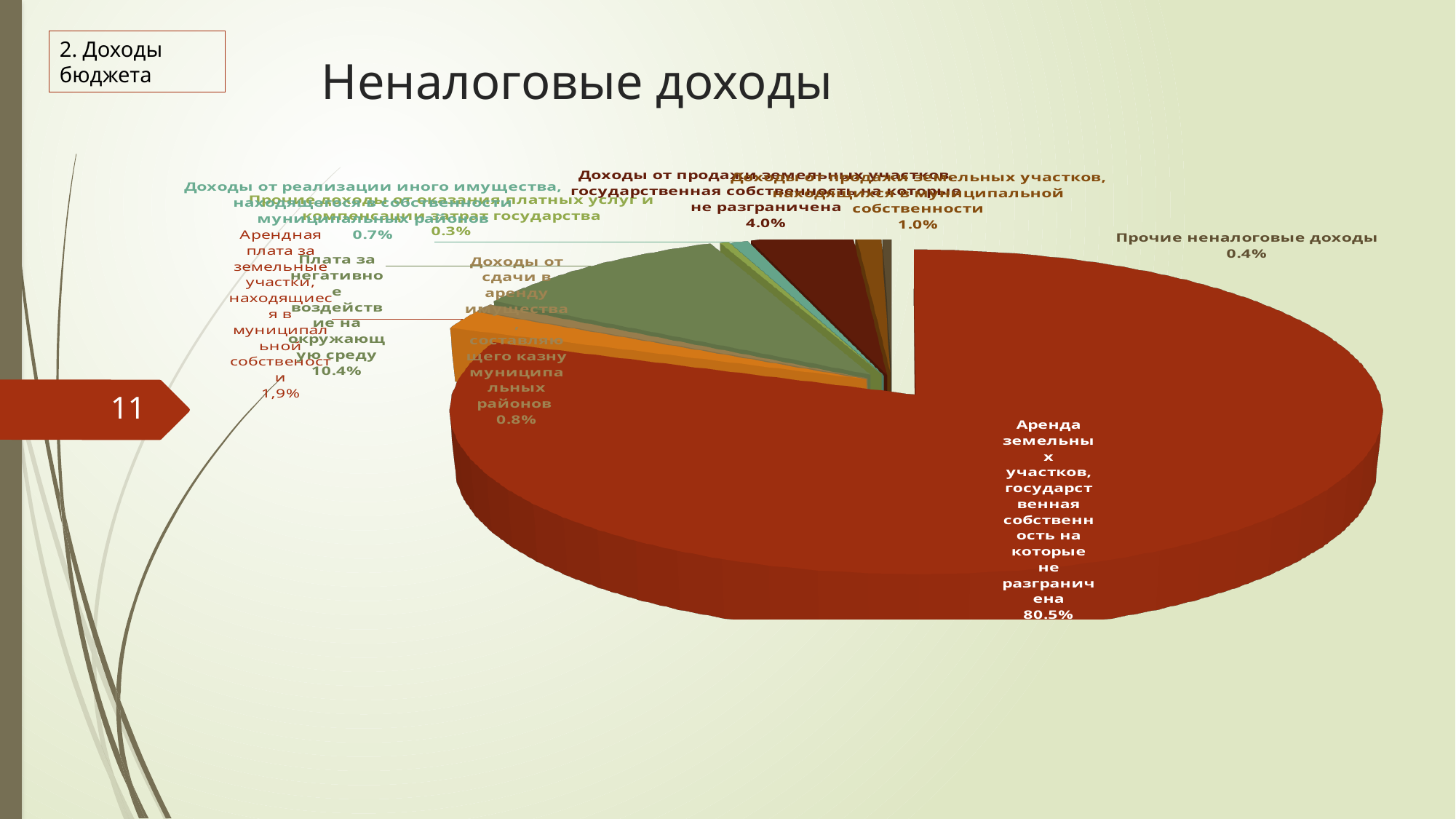
What kind of chart is shown on the slide? pie chart Which category has the largest share of the pie? Аренда земельных участков, государственная собственность на которые не разграничена Which category has the smallest share of the pie? Прочие доходы от оказания платных услуг и компенсации затрат государства What is the difference in percentage points between the share for "Аренда земельных участков, государственная собственность на которые не разграничена" and the share for "Плата за негативное воздействие на окружающую среду"? 70.1 Which is larger: the share for "Доходы от продажи земельных участков, государственная собственность на которые не разграничена" or the share for "Доходы от продажи земельных участков, находящихся в муниципальной собственности"? Доходы от продажи земельных участков, государственная собственность на которые не разграничена What share is shown for "Плата за негативное воздействие на окружающую среду"? 10.4% What share is shown for "Прочие неналоговые доходы"? 0.4% What share is shown for "Доходы от продажи земельных участков, государственная собственность на которые не разграничена"? 4.0% What share is shown for "Доходы от сдачи в аренду имущества, составляющего казну муниципальных районов"? 0.8% What share is shown for "Доходы от продажи земельных участков, находящихся в муниципальной собственности"? 1.0% What share of the pie is labelled for "Аренда земельных участков, государственная собственность на которые не разграничена"? 80.5% What is the title of the chart on the slide? Неналоговые доходы